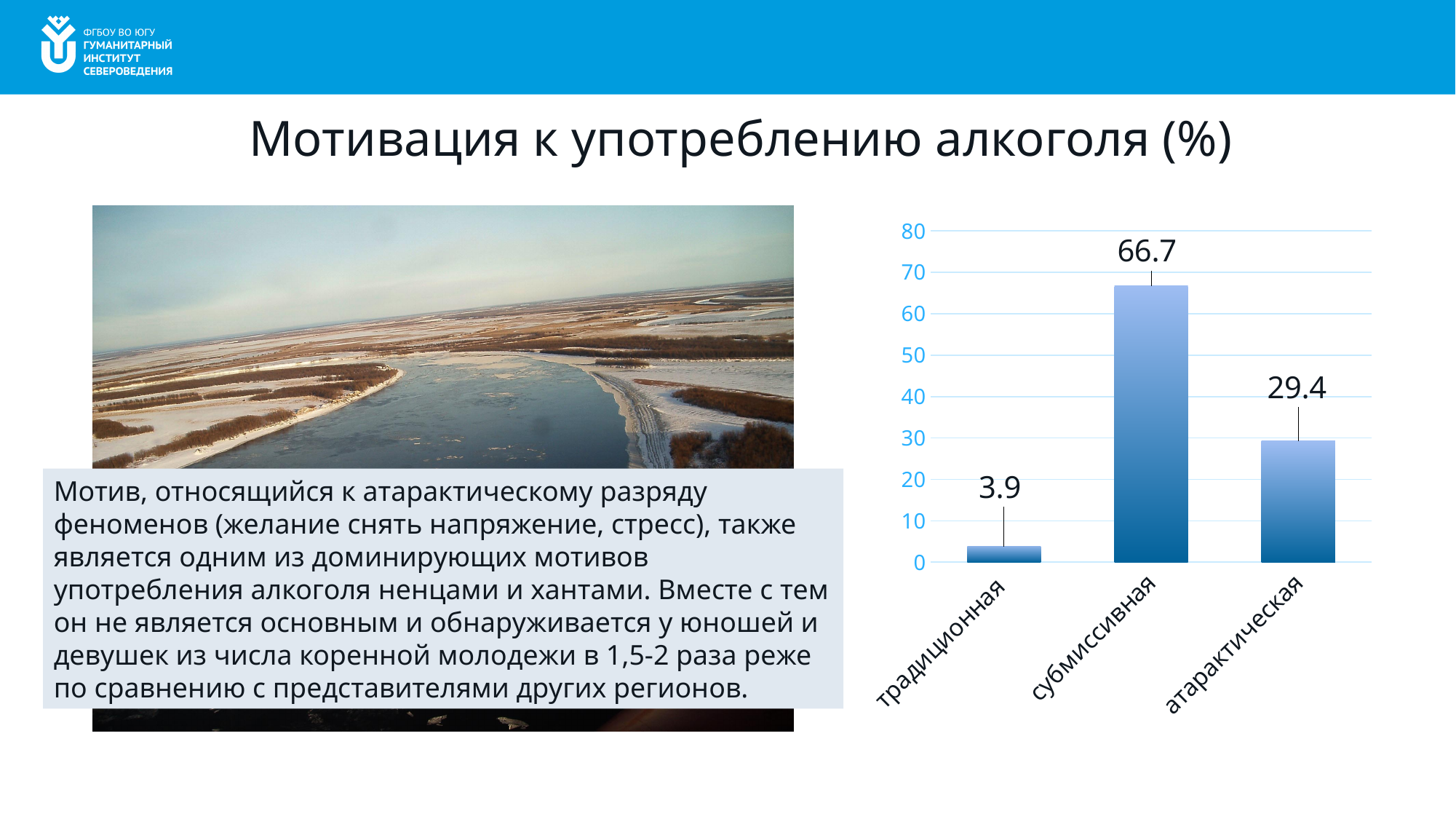
Which category has the highest value? субмиссивная What is the title of the slide containing the chart? Мотивация к употреблению алкоголя (%) What is the value for атарактическая? 29.4 Which category has the lowest value? традиционная What is the value for субмиссивная? 66.7 What kind of chart is shown on the slide? bar chart What is the difference between the values for атарактическая and традиционная? 25.5 What is the value for традиционная? 3.9 What is the difference between the values for субмиссивная and атарактическая? 37.3 How many categories are shown in the chart? 3 Which is larger, the value for атарактическая or the value for традиционная? атарактическая Is the value for субмиссивная greater or less than 60? greater